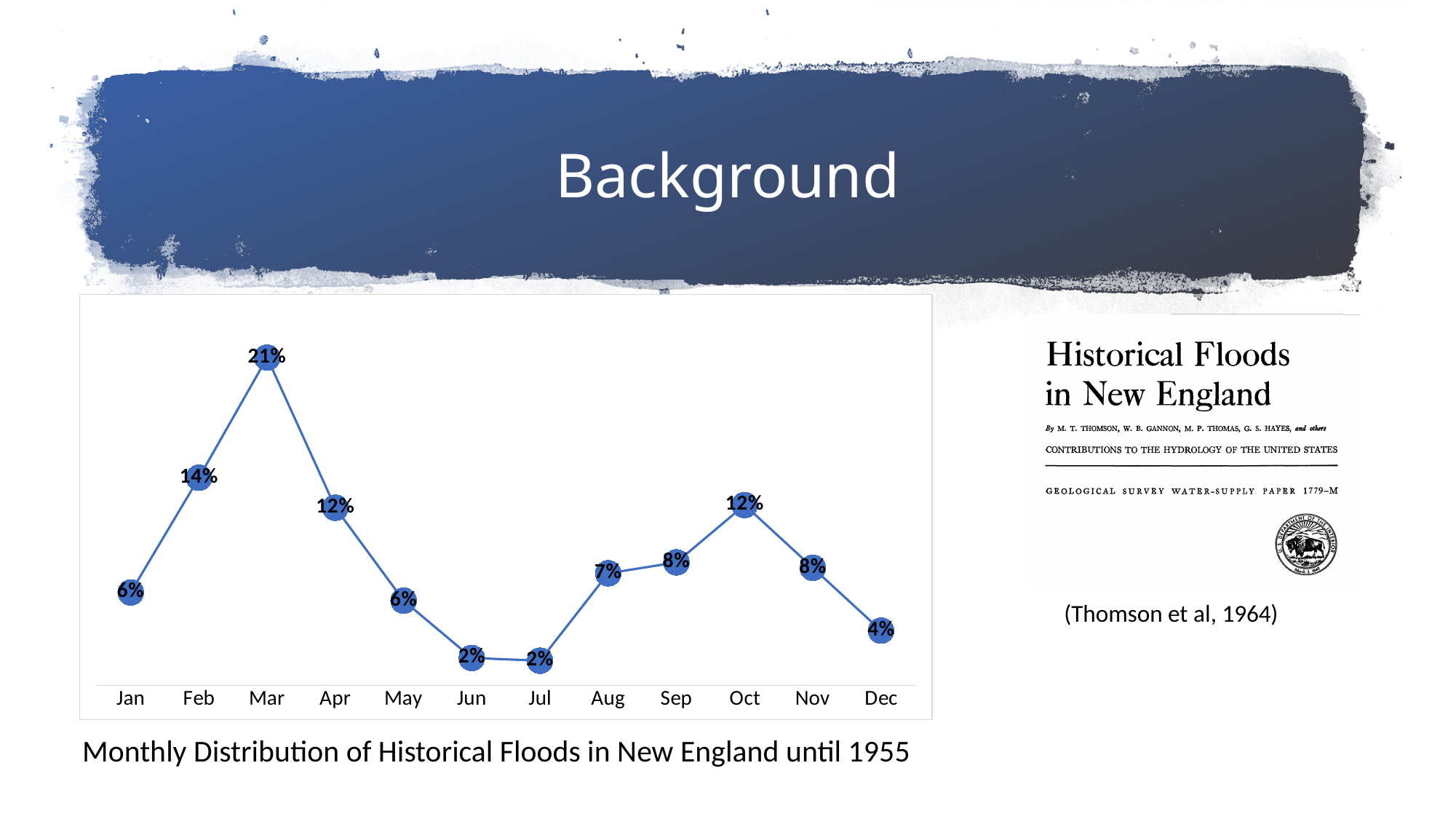
What is the value for March? 21% Do the values rise or fall from March to June? Fall What is the value for October? 12% What is the value for December? 4% What is the caption below the chart? Monthly Distribution of Historical Floods in New England until 1955 What is the difference between the values for October and September? 4% Which is larger, the value for August or the value for December? Aug What kind of chart is shown? Line chart What is the difference between the values for March and February? 7% How many months are plotted on the x axis? 12 Which is larger, the value for February or the value for November? Feb Which month has the highest value? Mar